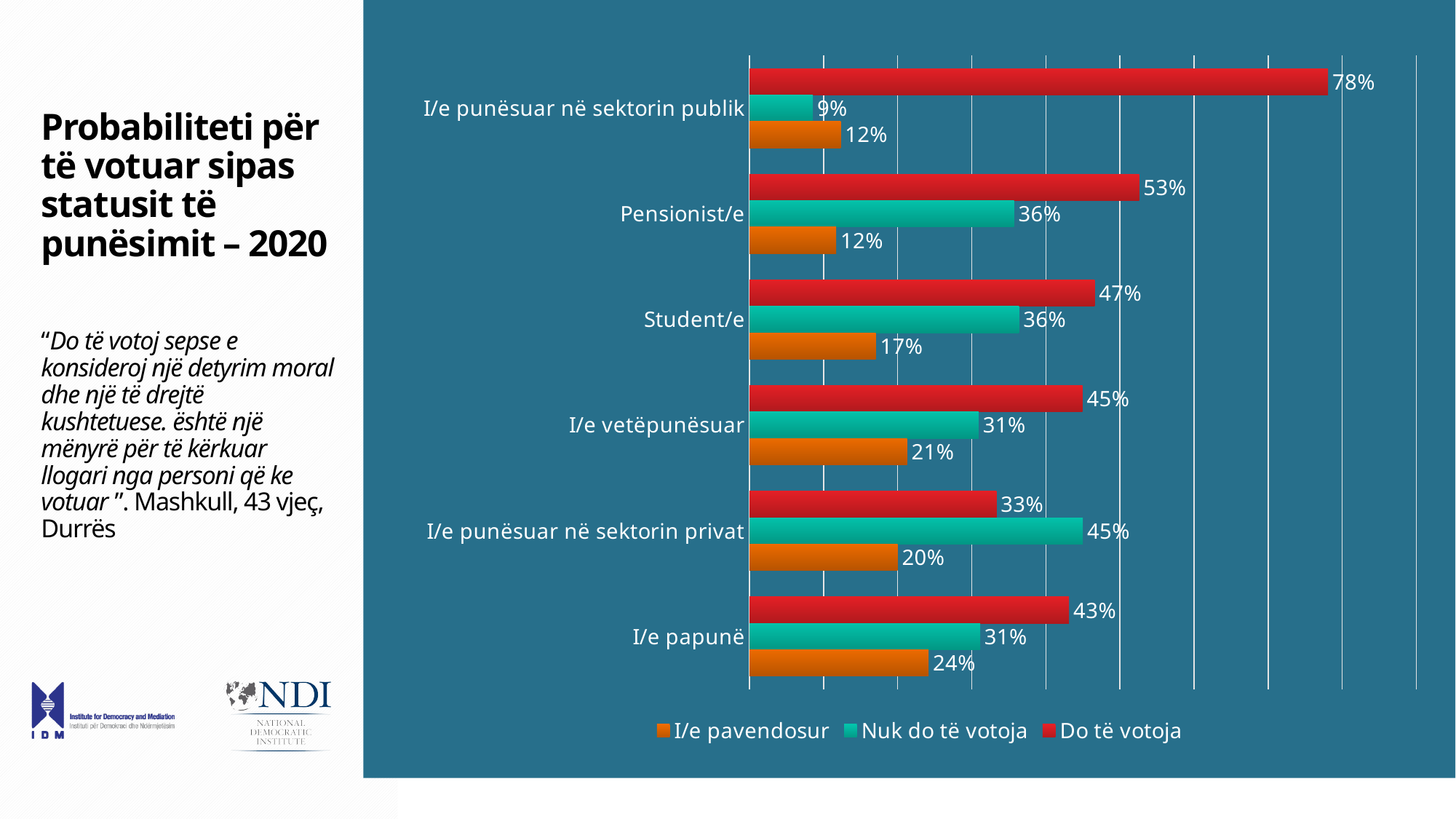
What is the 'I/e pavendosur' value for 'I/e vetëpunësuar'? 21% What is the difference between the 'Do të votoja' values for 'Pensionist/e' and 'Student/e'? 6% Which category has the highest 'Do të votoja' value? I/e punësuar në sektorin publik Which category has the lowest 'Nuk do të votoja' value? I/e punësuar në sektorin publik How many series does the legend list? 3 What is the 'Do të votoja' value for 'I/e punësuar në sektorin publik'? 78% What is the 'Nuk do të votoja' value for 'Pensionist/e'? 36% What is the 'I/e pavendosur' value for 'I/e papunë'? 24% For 'I/e punësuar në sektorin privat', which is larger: 'Do të votoja' or 'Nuk do të votoja'? Nuk do të votoja What kind of chart is shown on the slide? Bar chart How many employment status categories are shown on the chart? 6 What colour represents the 'Do të votoja' series? Red